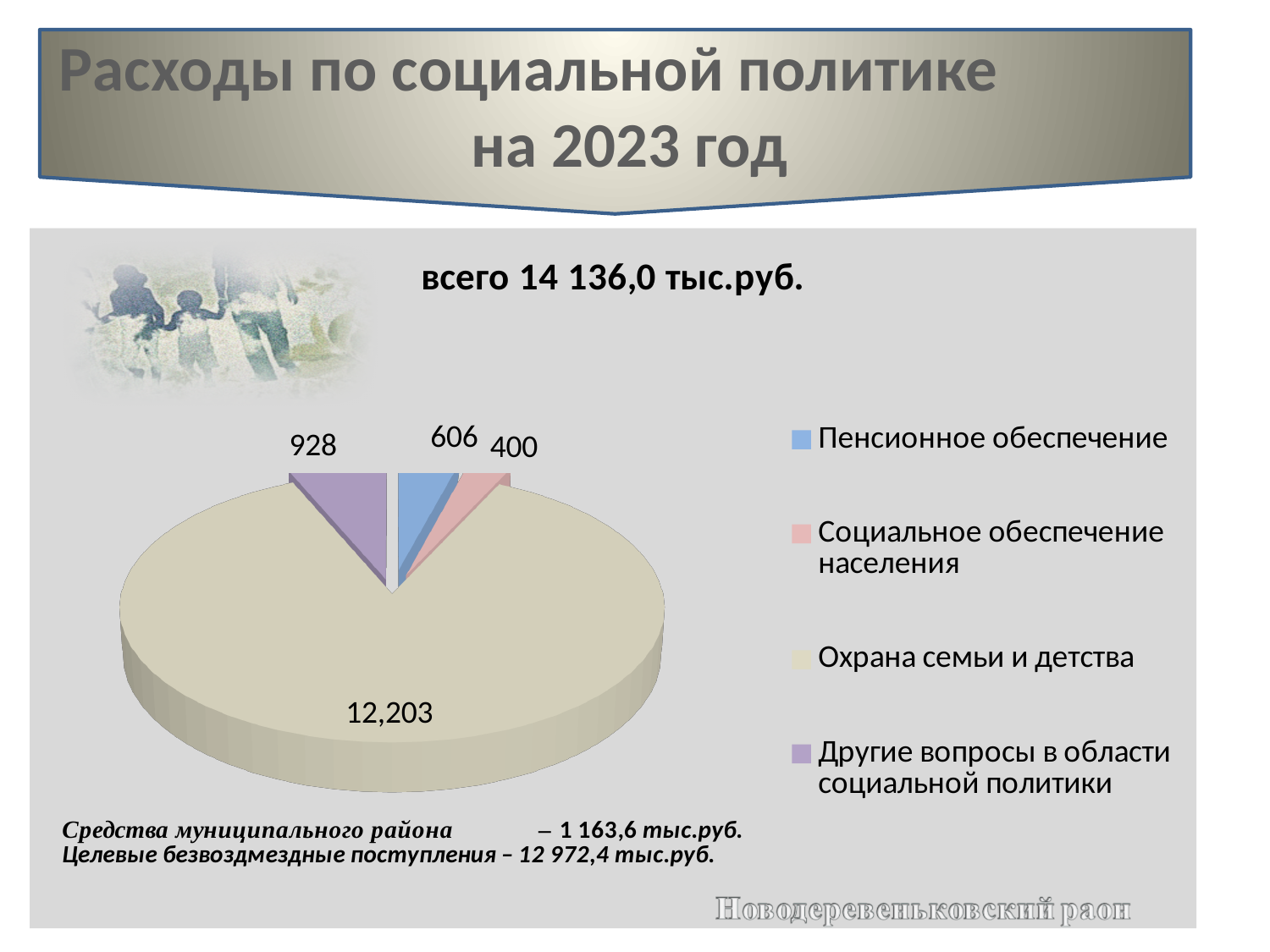
Which category has the smallest slice of the pie? Социальное обеспечение населения Which is larger, the value for Другие вопросы в области социальной политики or the value for Пенсионное обеспечение? Другие вопросы в области социальной политики What is the difference between the values for Другие вопросы в области социальной политики and Пенсионное обеспечение? 322 What kind of chart is shown on the slide? pie chart What colour is the slice for Охрана семьи и детства? beige What is the value for Социальное обеспечение населения? 400 What is the value for Другие вопросы в области социальной политики? 928 Which category has the largest slice of the pie? Охрана семьи и детства How many categories does the pie chart have? 4 What is the value for Охрана семьи и детства? 12,203 What is the difference between the values for Пенсионное обеспечение and Социальное обеспечение населения? 206 What is the value for Пенсионное обеспечение? 606